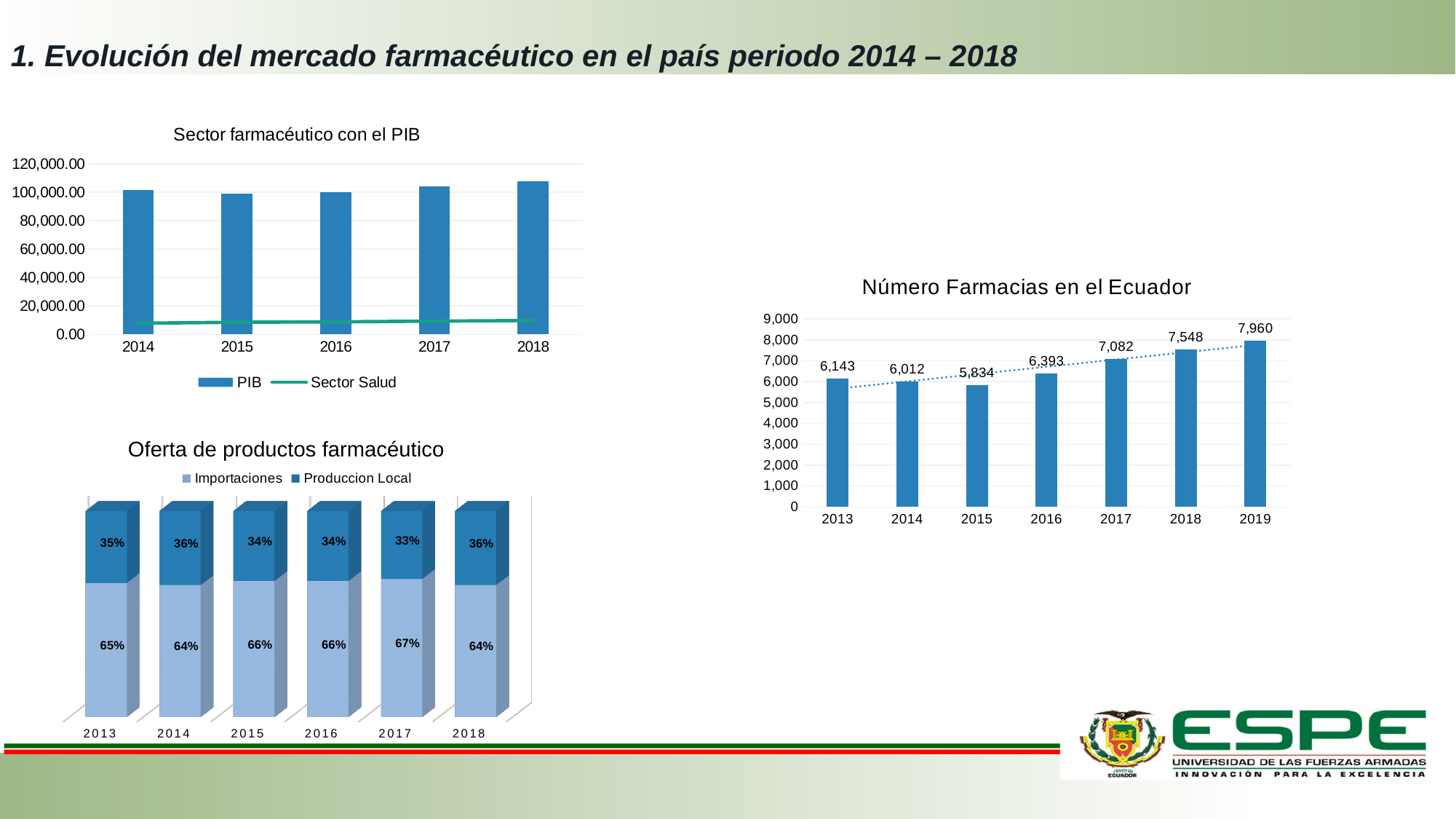
In the 'Número Farmacias en el Ecuador' chart, which year has the lowest value? 2015 In the 'Sector farmacéutico con el PIB' chart, which year has the highest PIB bar? 2018 In the 'Número Farmacias en el Ecuador' chart, is the value for 2014 greater or less than 6,000? greater In the 'Oferta de productos farmacéutico' chart, how many series does the legend list? 2 In the 'Oferta de productos farmacéutico' chart, what is the Importaciones share for 2017? 67% In the 'Oferta de productos farmacéutico' chart, which is larger in 2013: Importaciones or Produccion Local? Importaciones In the 'Número Farmacias en el Ecuador' chart, what is the value for 2019? 7,960 In the 'Número Farmacias en el Ecuador' chart, how many years are shown on the x axis? 7 In the 'Número Farmacias en el Ecuador' chart, what is the difference between the 2019 and 2013 values? 1,817 In the 'Sector farmacéutico con el PIB' chart, is the PIB value for 2018 greater or less than 100,000.00? greater In the 'Oferta de productos farmacéutico' chart, what is the Produccion Local share for 2015? 34% In the 'Sector farmacéutico con el PIB' chart, what are the two legend entries? PIB and Sector Salud